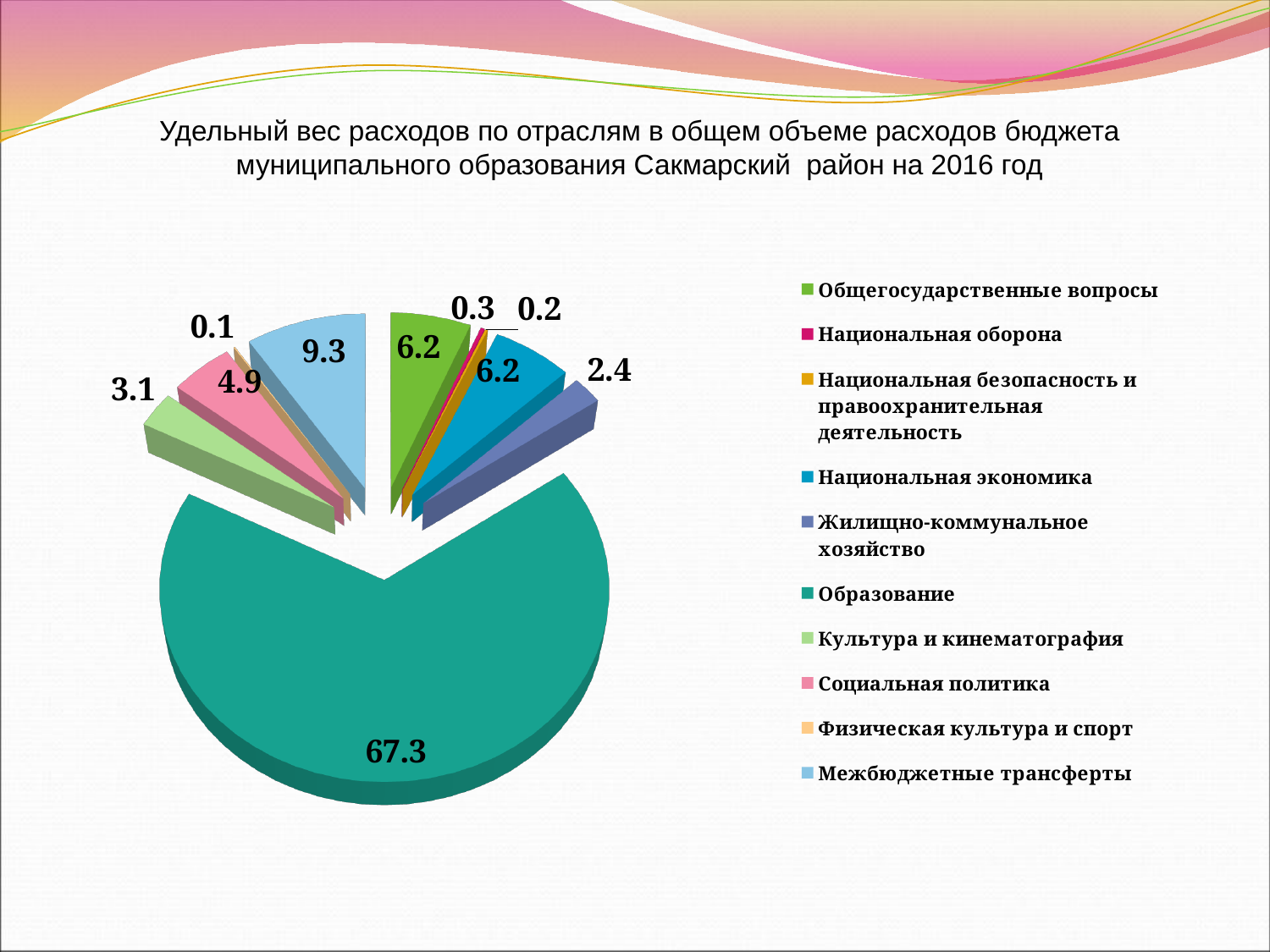
Which category has the largest share of the pie? Образование Which year does the chart title say the data refers to? 2016 What is the value for Социальная политика? 4.9 What is the value for Образование? 67.3 What is the value for Межбюджетные трансферты? 9.3 How many categories does the pie chart have? 10 Which category has the smallest share of the pie? Физическая культура и спорт What is the value for Национальная оборона? 0.3 What is the difference between the values for Межбюджетные трансферты and Социальная политика? 4.4 What is the value for Жилищно-коммунальное хозяйство? 2.4 Which is larger, the value for Культура и кинематография or the value for Жилищно-коммунальное хозяйство? Культура и кинематография What type of chart is shown on the slide? pie chart